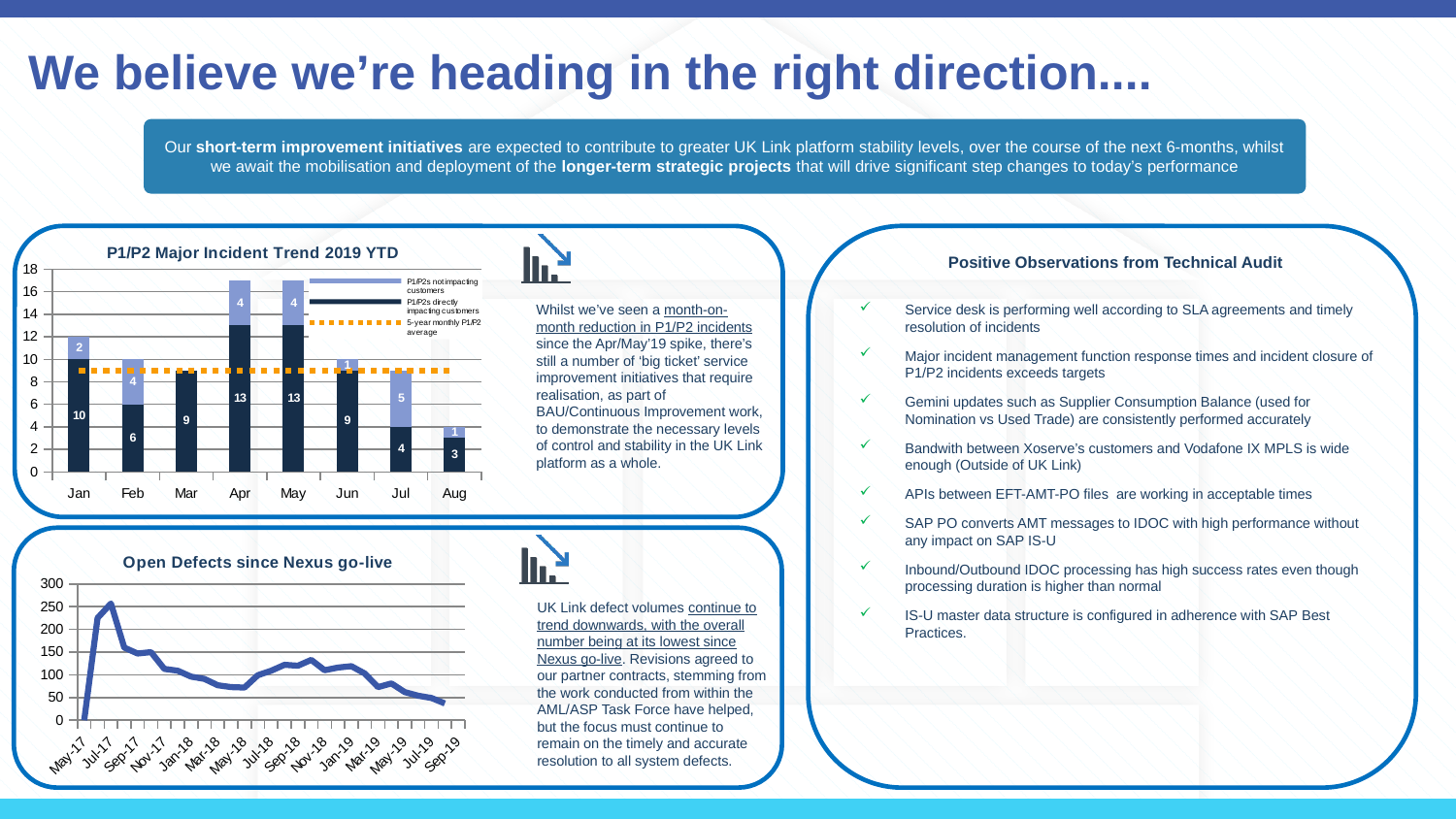
In the 'P1/P2 Major Incident Trend 2019 YTD' chart, which month has more P1/P2s directly impacting customers, Jan or Feb? Jan What kind of chart is the 'Open Defects since Nexus go-live' chart? Line chart In the 'P1/P2 Major Incident Trend 2019 YTD' chart, what is the total height of the stacked bar for Aug? 4 In the 'P1/P2 Major Incident Trend 2019 YTD' chart, what is the difference between the P1/P2s directly impacting customers in Apr and in Feb? 7 In the 'P1/P2 Major Incident Trend 2019 YTD' chart, what is the total height of the stacked bar for Apr? 17 How many months are shown on the x axis of the 'P1/P2 Major Incident Trend 2019 YTD' chart? 8 What kind of chart is the 'P1/P2 Major Incident Trend 2019 YTD' chart? Combination bar and line chart (stacked bars with a dashed average line) In the 'P1/P2 Major Incident Trend 2019 YTD' chart, how many P1/P2s not impacting customers were there in Jul? 5 In the 'P1/P2 Major Incident Trend 2019 YTD' chart, which month has the lowest number of P1/P2s directly impacting customers? Aug In the 'P1/P2 Major Incident Trend 2019 YTD' chart, how many P1/P2s directly impacting customers were there in Jan? 10 How many entries does the legend of the 'P1/P2 Major Incident Trend 2019 YTD' chart list? 3